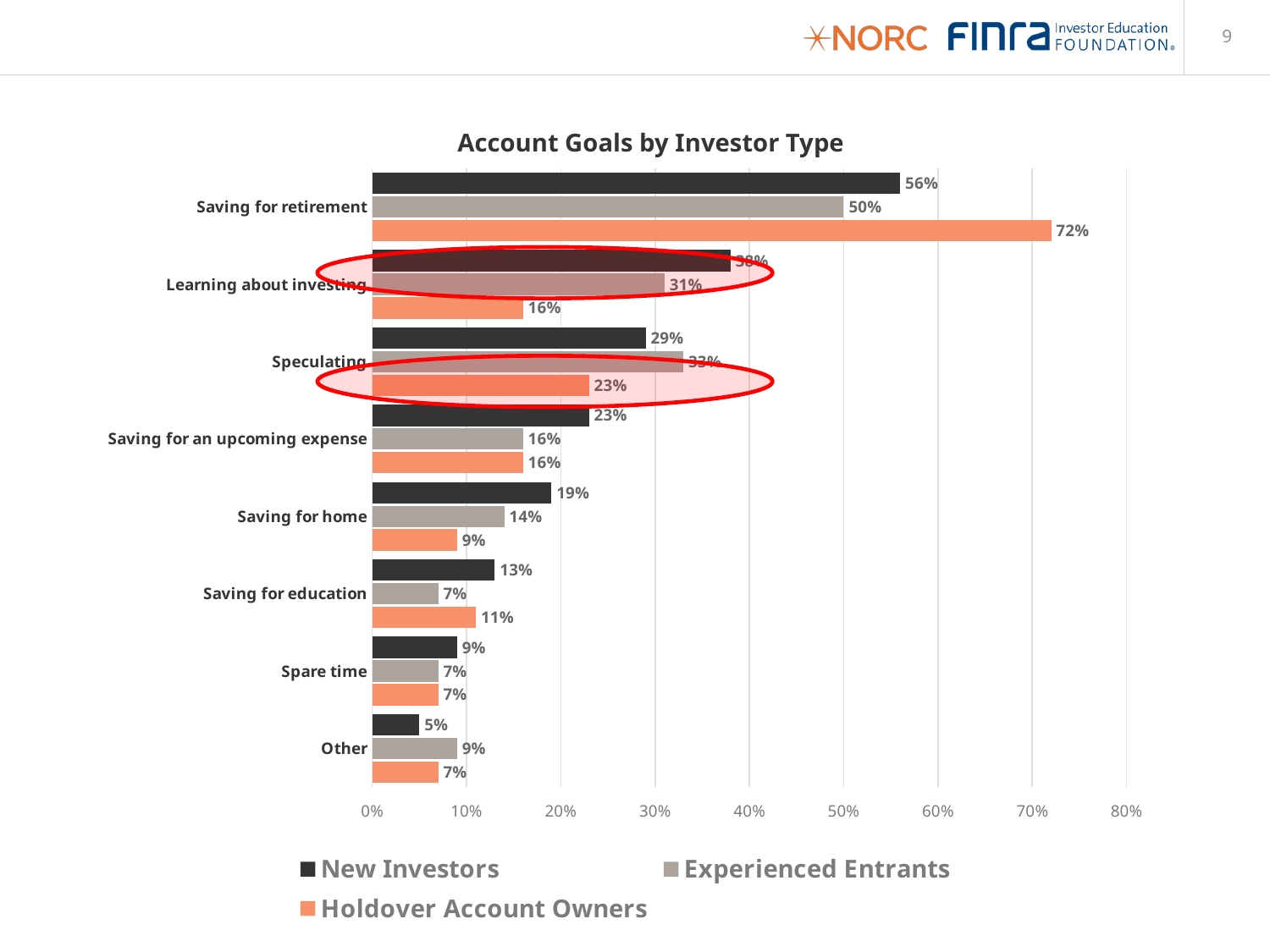
Is the value for New Investors for Learning about investing greater or less than 30%? greater What is the title of the chart? Account Goals by Investor Type For Saving for home, which is larger: New Investors or Holdover Account Owners? New Investors What is the value for Experienced Entrants for Learning about investing? 31% How many series does the legend list? 3 What type of chart is shown on the slide? bar chart Which account goal has the lowest value for New Investors? Other Which account goal has the highest value for Holdover Account Owners? Saving for retirement What is the value for New Investors for Saving for retirement? 56% What is the value for Holdover Account Owners for Saving for retirement? 72% How many account goal categories are shown on the chart? 8 What is the difference between Holdover Account Owners and Experienced Entrants for Saving for retirement? 22%